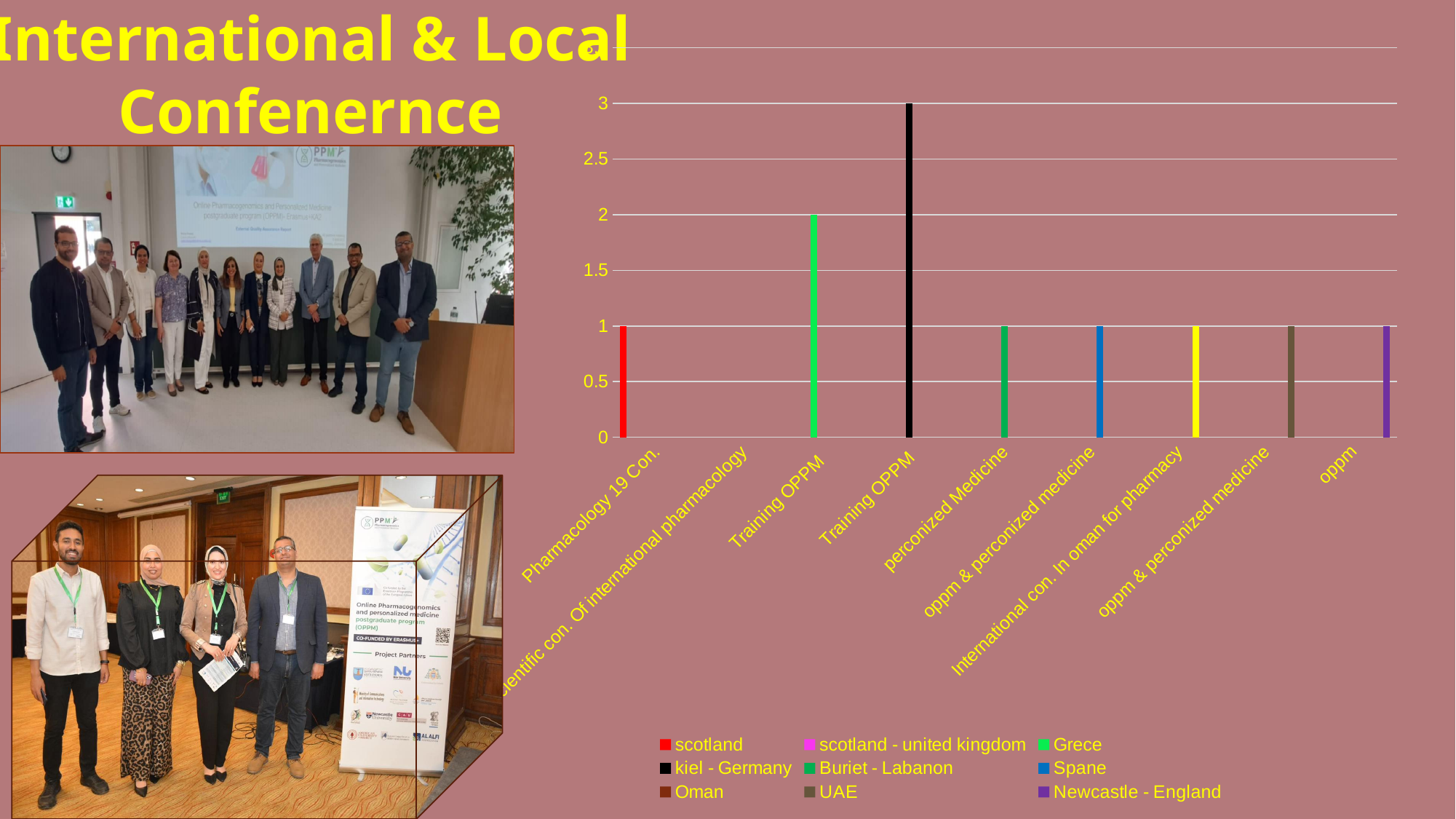
How many category labels are shown along the x axis? 9 What is the difference between the kiel - Germany bar and the Grece bar? 1 What is the value of the scotland bar (Pharmacology 19 Con.)? 1 What kind of chart is shown on the slide? bar chart How many series does the legend list? 9 What is the value of the kiel - Germany bar? 3 Which is larger, the Grece bar or the Spane bar? Grece What is the value of the Newcastle - England bar (oppm)? 1 Which series has the highest bar in the chart? kiel - Germany What is the value of the Grece bar? 2 What colour does the legend use for kiel - Germany? black Is the value of the kiel - Germany bar greater or less than 2.5? greater